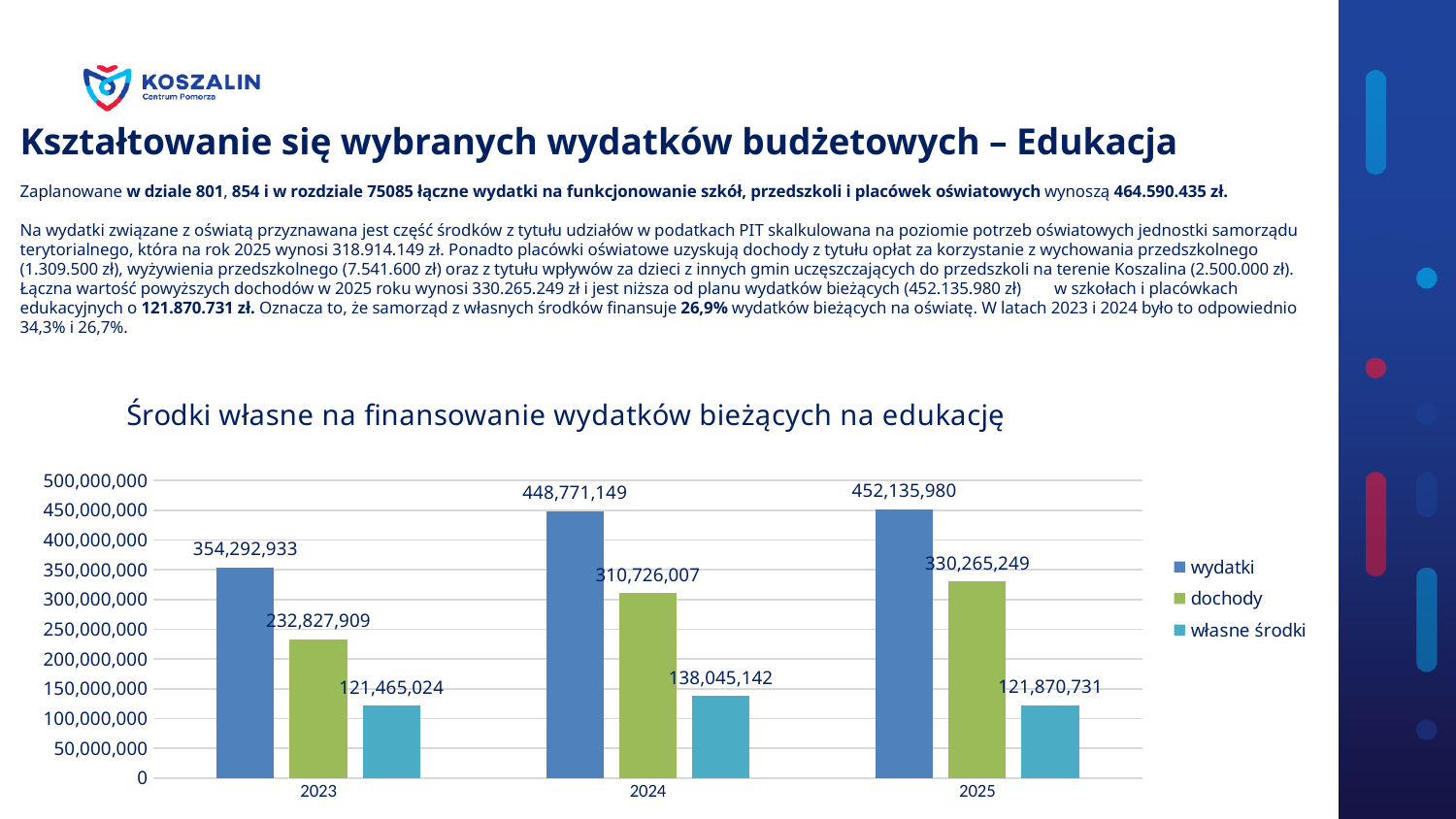
What is the value of wydatki for 2024? 448,771,149 What is the value of dochody for 2025? 330,265,249 What is the value of własne środki for 2023? 121,465,024 How many series does the legend list? 3 Is the value of dochody for 2023 greater or less than 250,000,000? less What is the difference between wydatki and dochody in 2025? 121,870,731 In which year is wydatki the highest? 2025 In which year is dochody the lowest? 2023 Which is larger: własne środki in 2024 or własne środki in 2025? własne środki in 2024 What kind of chart is shown on the slide? bar chart How many years are shown on the x axis? 3 What is the difference between wydatki in 2024 and wydatki in 2023? 94,478,216